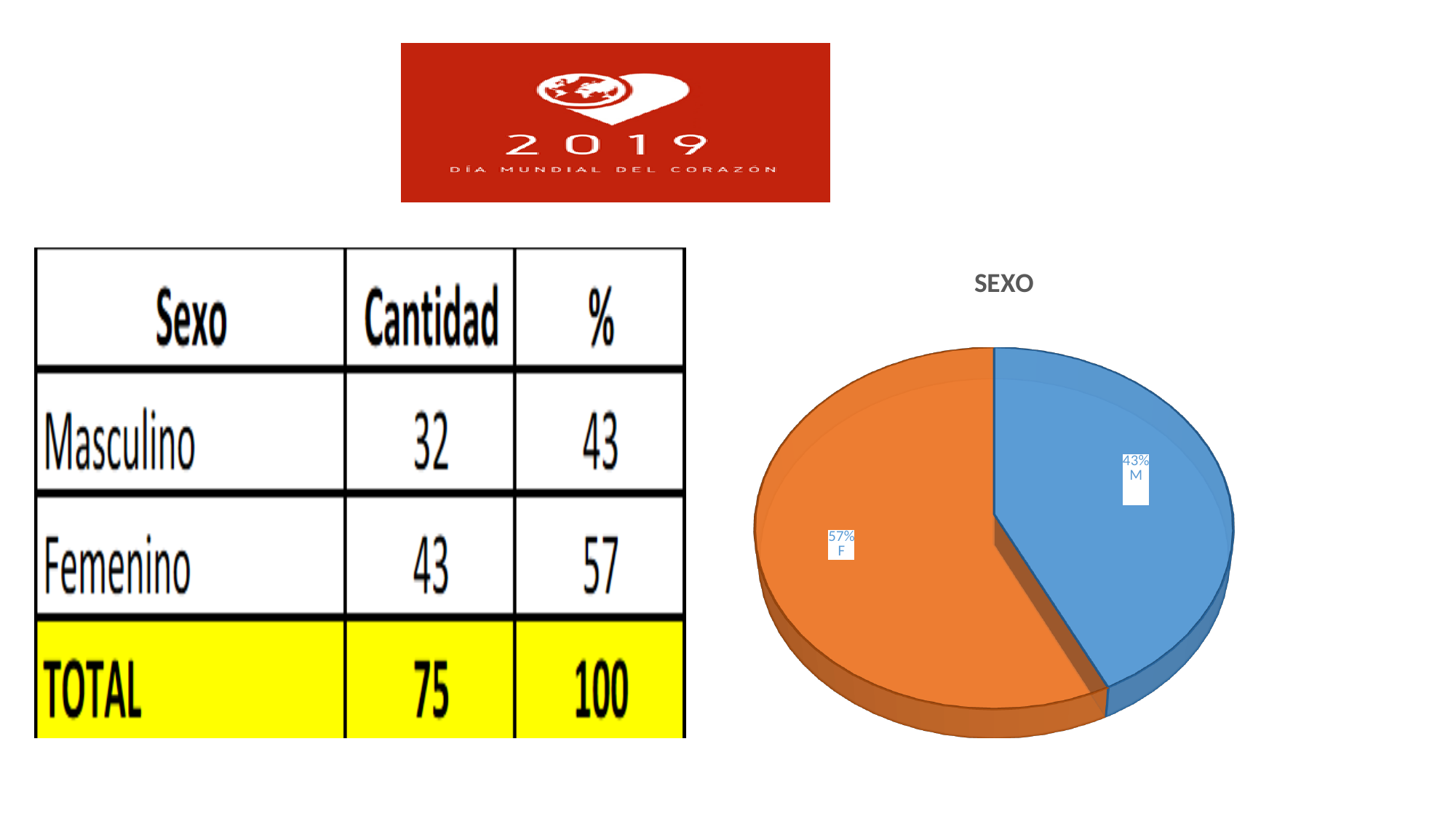
What share of the pie chart does the M slice represent? 43% Which slice of the pie chart is the largest? F Which slice of the pie chart is the smallest? M What kind of chart is shown under the title SEXO? pie chart In the pie chart, which slice is larger, M or F? F What share of the pie chart does the F slice represent? 57% Is the share of the F slice in the pie chart greater or less than 50%? greater What is the title of the pie chart? SEXO What is the difference in percentage points between the F slice and the M slice in the pie chart? 14 How many slices does the pie chart have? 2 What colour is the M slice in the pie chart? blue